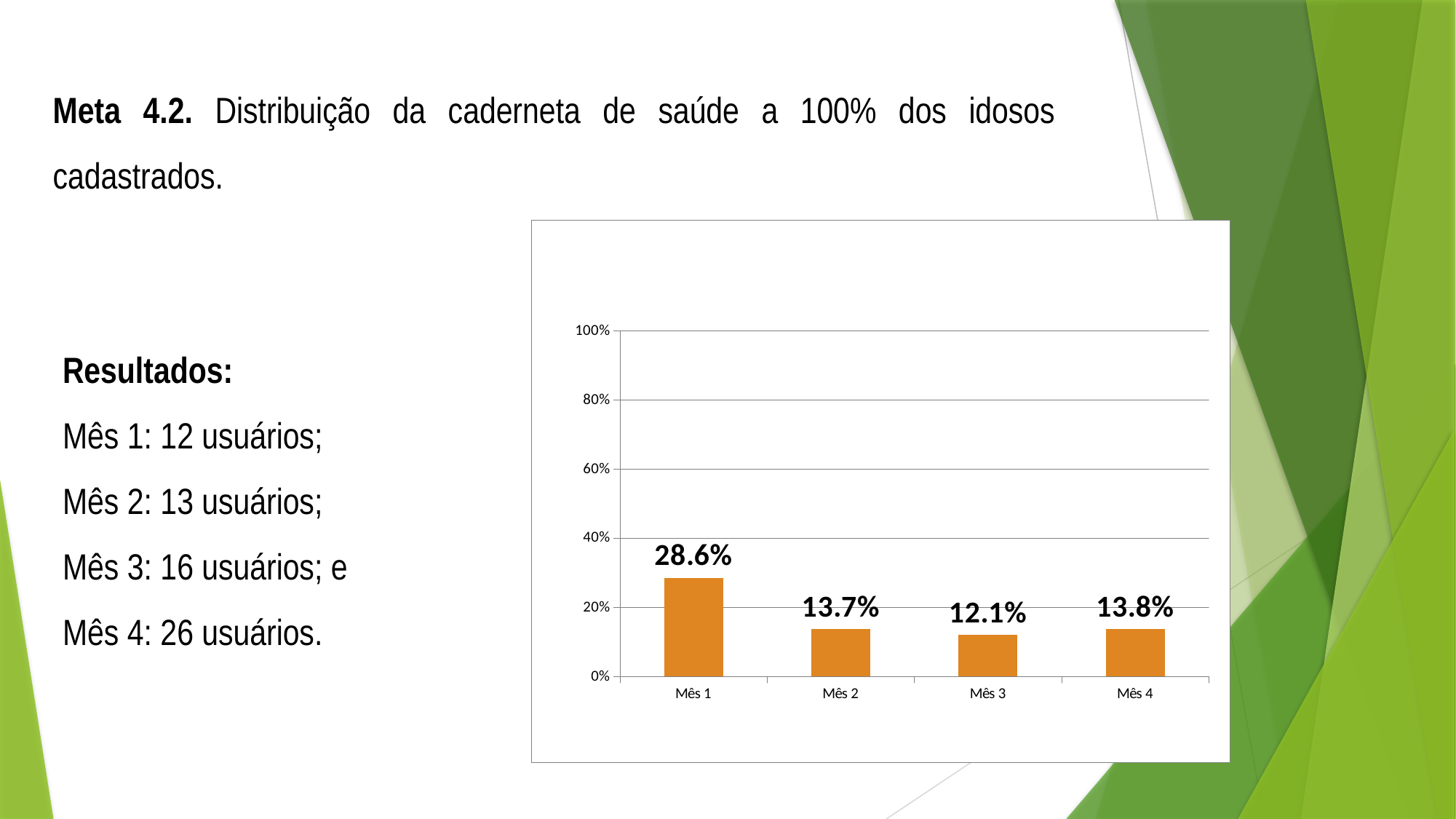
What is the difference between the values for Mês 4 and Mês 3? 1.7% How many months are shown on the x axis? 4 Which month has the highest value? Mês 1 Which is larger, the value for Mês 1 or the value for Mês 4? Mês 1 What is the value for Mês 3? 12.1% What is the difference between the values for Mês 1 and Mês 2? 14.9% What is the value for Mês 1? 28.6% Is the value for Mês 1 greater or less than 20%? greater What kind of chart is shown on the slide? bar chart Which month has the lowest value? Mês 3 What is the value for Mês 2? 13.7% What is the value for Mês 4? 13.8%